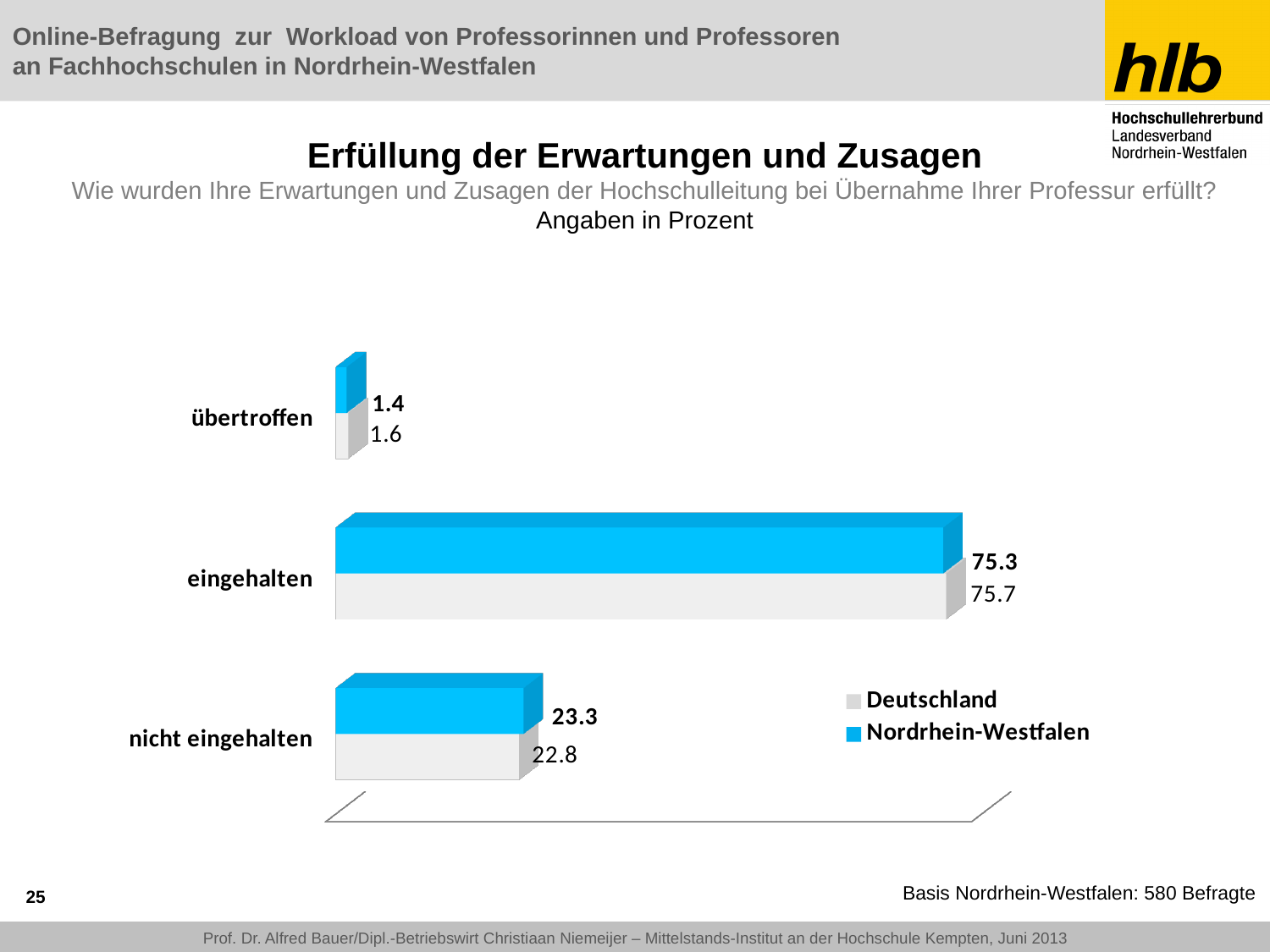
What is the value for Deutschland in the 'übertroffen' category? 1.6 What is the value for Deutschland in the 'nicht eingehalten' category? 22.8 What is the difference between the Nordrhein-Westfalen values for 'eingehalten' and 'nicht eingehalten'? 52.0 What is the difference between the Deutschland and Nordrhein-Westfalen values in the 'eingehalten' category? 0.4 Which category has the lowest value for Deutschland? übertroffen What is the value for Nordrhein-Westfalen in the 'nicht eingehalten' category? 23.3 Which category has the highest value for Nordrhein-Westfalen? eingehalten What is the value for Nordrhein-Westfalen in the 'eingehalten' category? 75.3 What kind of chart is shown on the slide? bar chart Which is larger in the 'nicht eingehalten' category: Deutschland or Nordrhein-Westfalen? Nordrhein-Westfalen How many categories are shown in the chart? 3 How many series does the legend list? 2